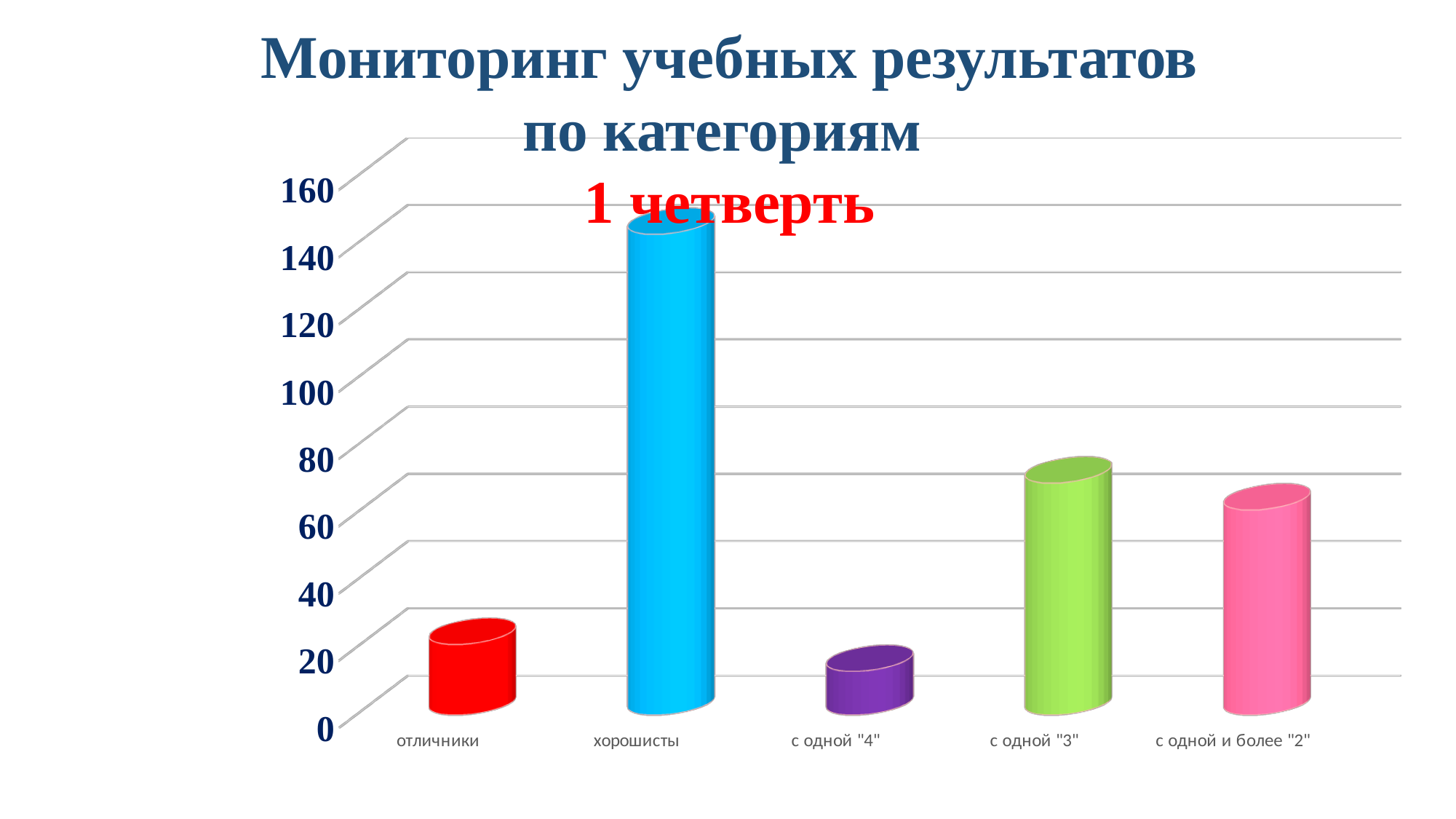
Is the value for с одной и более "2" greater or less than 40? greater Is the value for с одной "4" greater or less than 40? less Which is larger, the value for с одной "3" or the value for с одной и более "2"? с одной "3" Which category has the lowest value in the chart? с одной "4" Is the value for отличники greater or less than 40? less Which category has the highest value in the chart? хорошисты What period is indicated in red text above the chart? 1 четверть What kind of chart is shown on the slide? bar chart How many categories are shown on the x axis of the chart? 5 Which is larger, the value for отличники or the value for с одной "4"? отличники